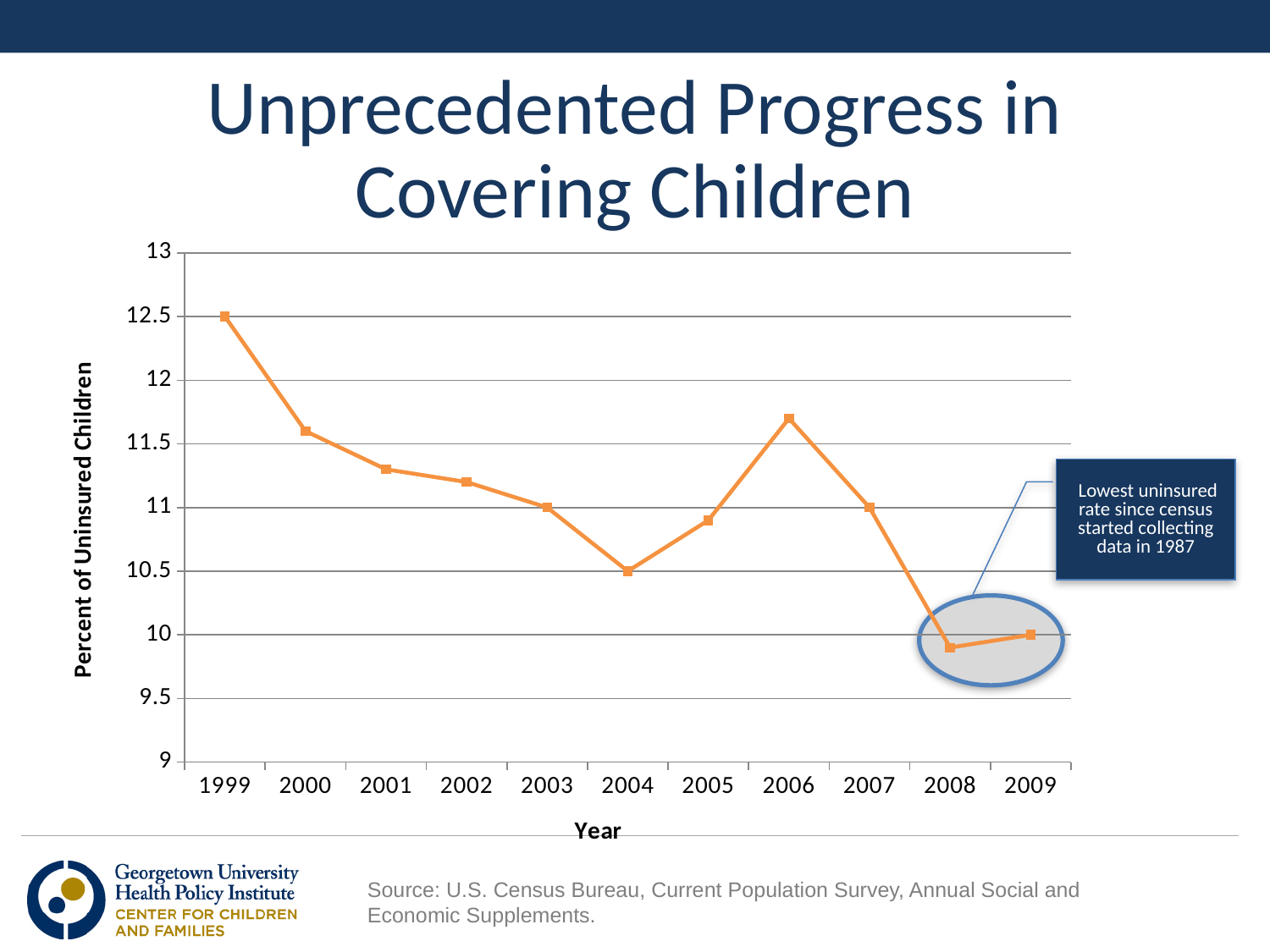
What is the percent of uninsured children in 1999? 12.5 Which year has the highest percent of uninsured children? 1999 What is the difference between the values for 1999 and 2009? 2.5 What type of chart is shown on the slide? Line chart What is the percent of uninsured children in 2004? 10.5 What is the percent of uninsured children in 2003? 11 What is the label on the y axis? Percent of Uninsured Children Which year has the larger value, 2005 or 2006? 2006 How many years are plotted on the x axis? 11 Is the value for 2008 greater or less than 10? less Is the value for 2006 greater or less than 11.5? greater What is the percent of uninsured children in 2009? 10